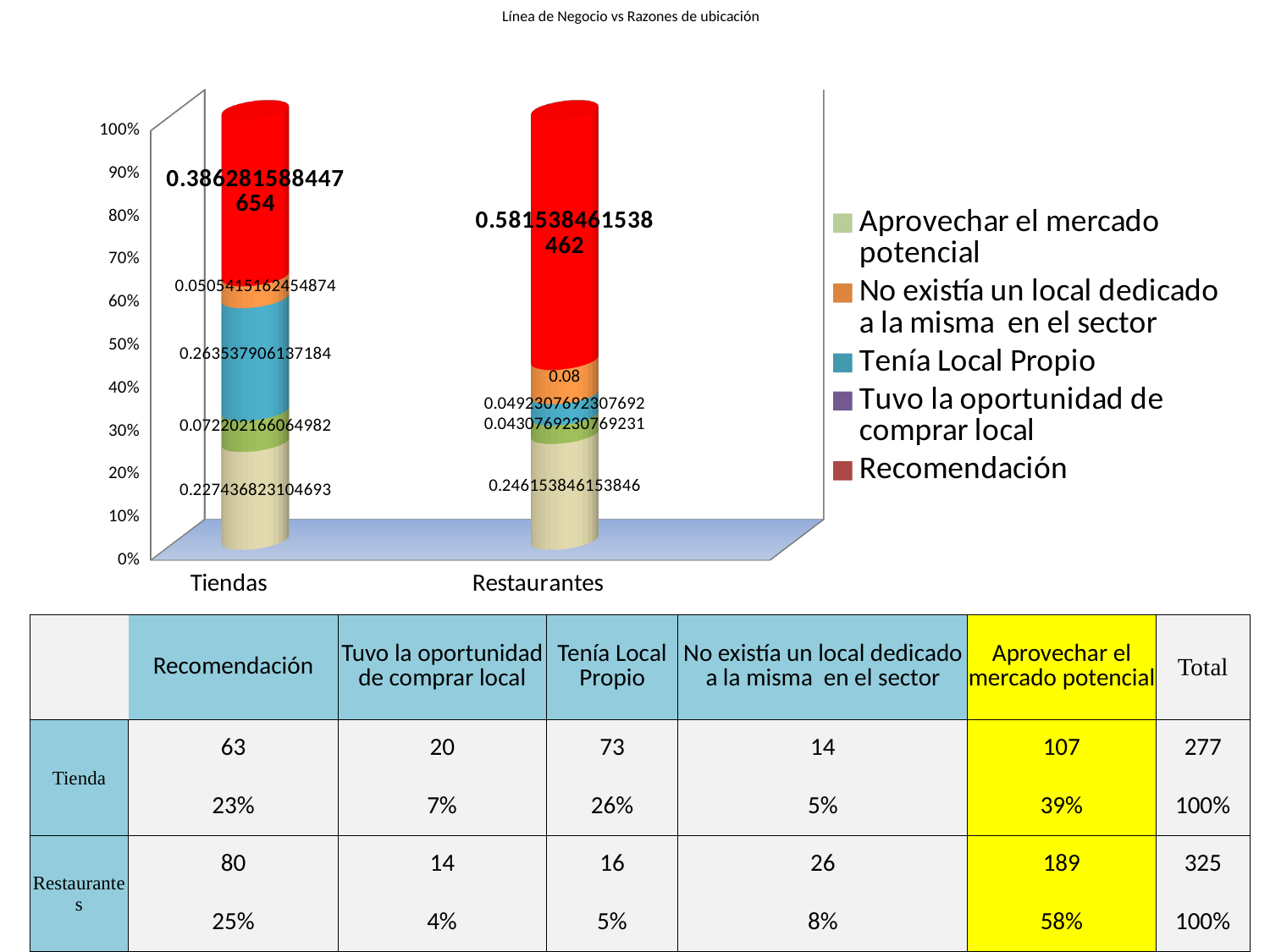
What is the difference between the largest data label on the Restaurantes bar and the largest data label on the Tiendas bar? 0.195256873090808 What is the largest data label printed on the Tiendas bar? 0.386281588447654 What value is printed on the bottom segment of the Tiendas bar? 0.227436823104693 How many series does the chart legend list? 5 Which legend entry is listed first in the chart legend? Aprovechar el mercado potencial How many categories are shown on the x axis of the chart? 2 What kind of chart is shown on the slide? Stacked bar chart What is the title of the chart? Línea de Negocio vs Razones de ubicación Which bar has the larger top (red) segment, Tiendas or Restaurantes? Restaurantes What is the smallest data label printed on the Tiendas bar? 0.0505415162454874 What is the largest data label printed on the Restaurantes bar? 0.581538461538462 What value is printed on the bottom segment of the Restaurantes bar? 0.246153846153846